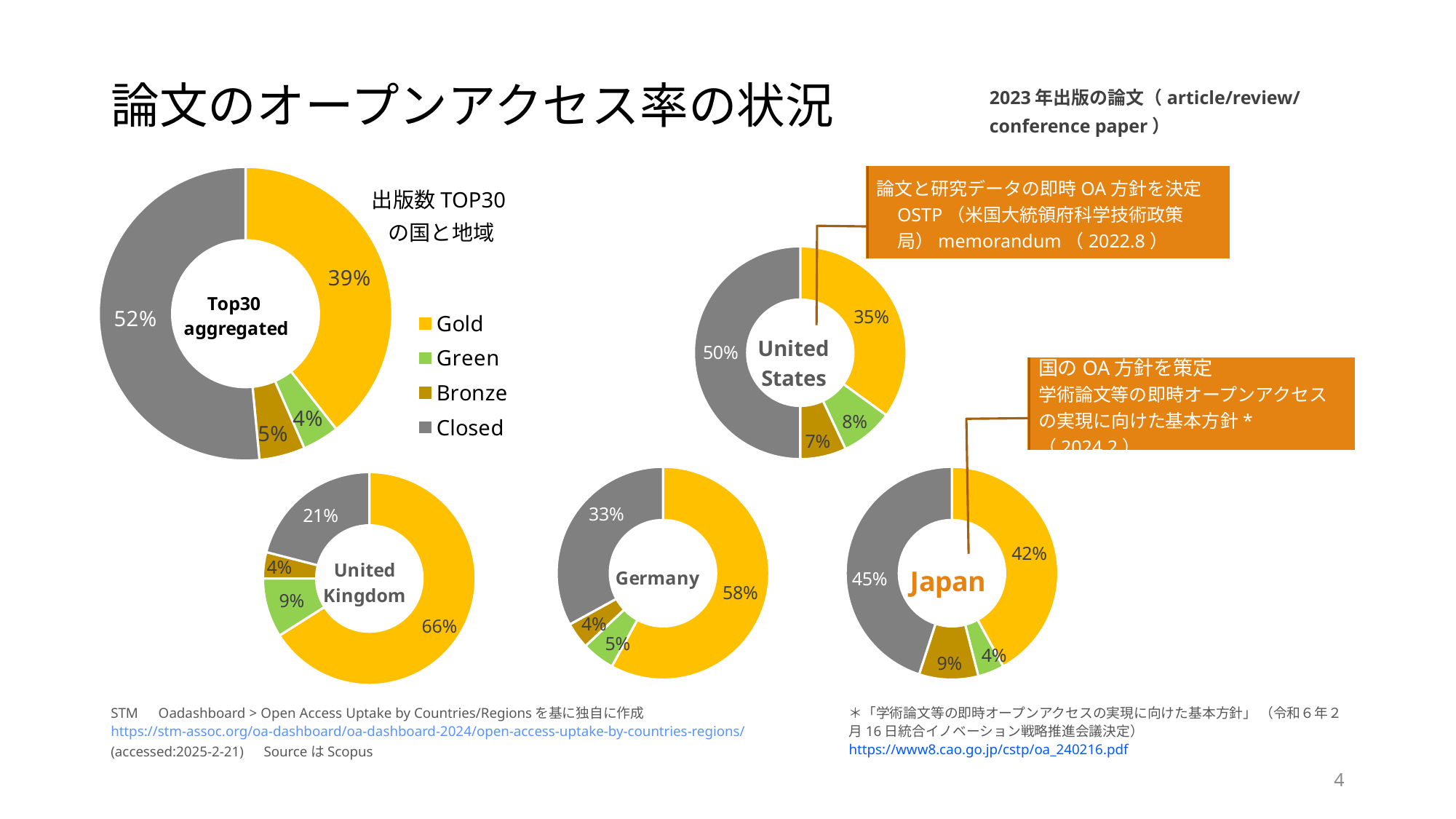
How many donut charts are shown on the slide? 5 In the United States chart, what is the Bronze share? 7% How many categories does the legend list? 4 In the Germany chart, what is the Green share? 5% Which is larger: the Gold share in the United Kingdom chart or the Gold share in the Germany chart? United Kingdom In the legend, which colour represents Closed? Grey In the Top30 aggregated chart, which category has the largest share? Closed In the United Kingdom chart, what is the Closed share? 21% What kind of chart is used to show the open access shares on this slide? Donut (pie) chart In the Japan chart, what is the Gold share? 42% In the Japan chart, what is the difference between the Closed share and the Gold share? 3% In the United Kingdom chart, which category has the smallest share? Bronze